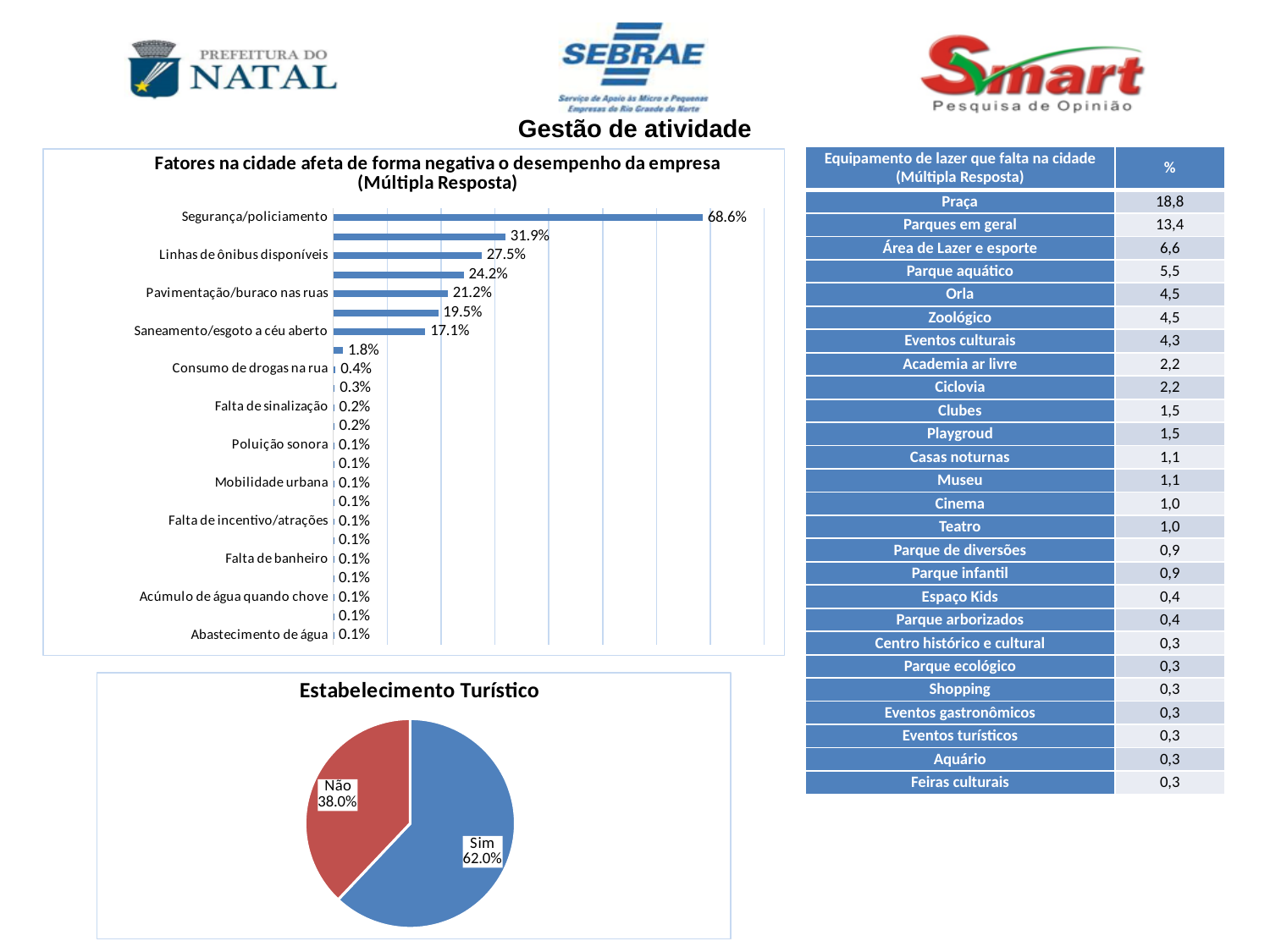
In the pie chart 'Estabelecimento Turístico', what is the share for Não? 38.0% How many bars are plotted in the chart 'Fatores na cidade afeta de forma negativa o desempenho da empresa'? 23 In the pie chart 'Estabelecimento Turístico', what is the difference between the Sim and Não shares? 24.0% In the bar chart 'Fatores na cidade afeta de forma negativa o desempenho da empresa', what is the value for Saneamento/esgoto a céu aberto? 17.1% In the bar chart 'Fatores na cidade afeta de forma negativa o desempenho da empresa', what is the value for Pavimentação/buraco nas ruas? 21.2% In the bar chart 'Fatores na cidade afeta de forma negativa o desempenho da empresa', which category has the highest value? Segurança/policiamento In the pie chart 'Estabelecimento Turístico', what is the share for Sim? 62.0% In the bar chart 'Fatores na cidade afeta de forma negativa o desempenho da empresa', what is the value for Linhas de ônibus disponíveis? 27.5% In the bar chart 'Fatores na cidade afeta de forma negativa o desempenho da empresa', which is larger: Pavimentação/buraco nas ruas or Saneamento/esgoto a céu aberto? Pavimentação/buraco nas ruas What kind of chart is 'Fatores na cidade afeta de forma negativa o desempenho da empresa'? Bar chart In the bar chart 'Fatores na cidade afeta de forma negativa o desempenho da empresa', what is the difference between Segurança/policiamento and Linhas de ônibus disponíveis? 41.1% In the bar chart 'Fatores na cidade afeta de forma negativa o desempenho da empresa', what is the value for Segurança/policiamento? 68.6%